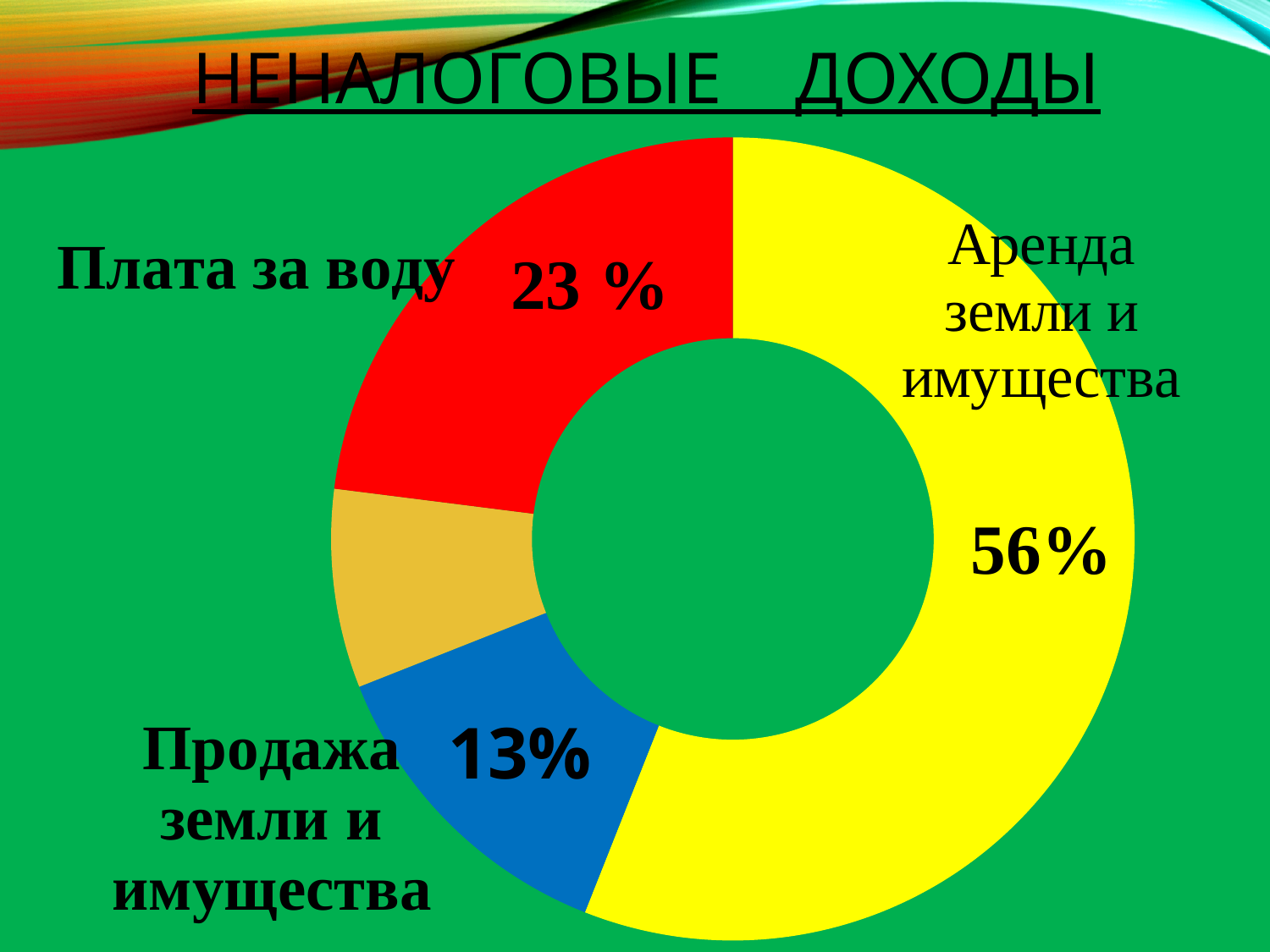
How many slices does the chart have? 4 What percentage does the chart show for Аренда земли и имущества? 56% What percentage does the chart show for Продажа земли и имущества? 13% Which category has the largest share of the chart? Аренда земли и имущества What kind of chart is shown on the slide? Pie (doughnut) chart Which is larger, the share for Плата за воду or the share for Продажа земли и имущества? Плата за воду What percentage does the chart show for Плата за воду? 23 % By how many percentage points does Аренда земли и имущества exceed Продажа земли и имущества? 43 What is the title of the slide? НЕНАЛОГОВЫЕ ДОХОДЫ By how many percentage points does Плата за воду exceed Продажа земли и имущества? 10 By how many percentage points does Аренда земли и имущества exceed Плата за воду? 33 What colour is the slice for Аренда земли и имущества? Yellow